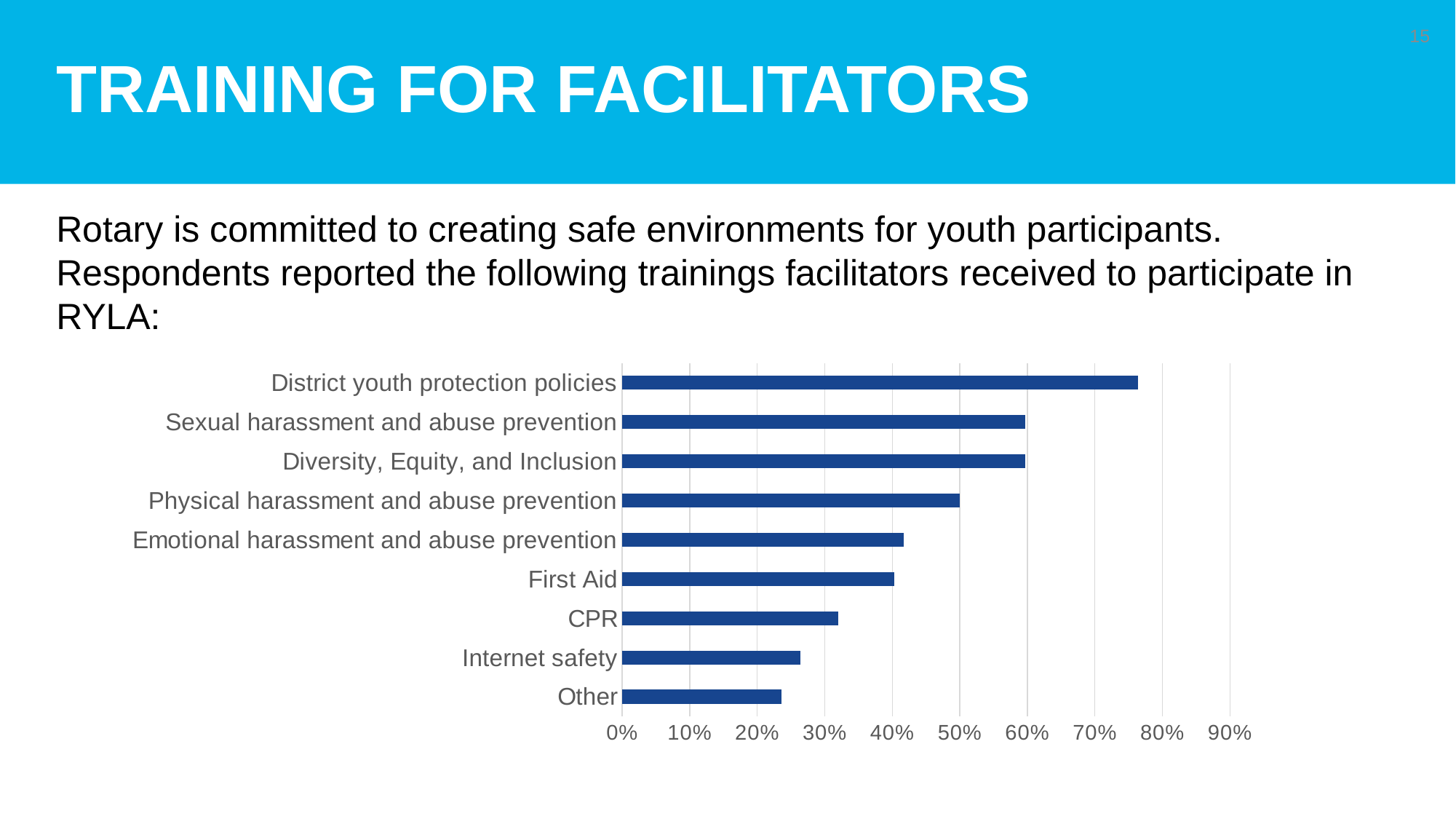
Is the value for Sexual harassment and abuse prevention greater or less than 50%? greater What kind of chart is shown on the slide? bar chart Which training category has the lowest value? Other Which training category has the highest value? District youth protection policies Which is larger, the value for Physical harassment and abuse prevention or the value for First Aid? Physical harassment and abuse prevention Which is larger, the value for District youth protection policies or the value for CPR? District youth protection policies Is the value for District youth protection policies greater or less than 70%? greater What is the highest percentage tick shown on the horizontal axis? 90% Is the value for Internet safety greater or less than 30%? less How many training categories are shown in the chart? 9